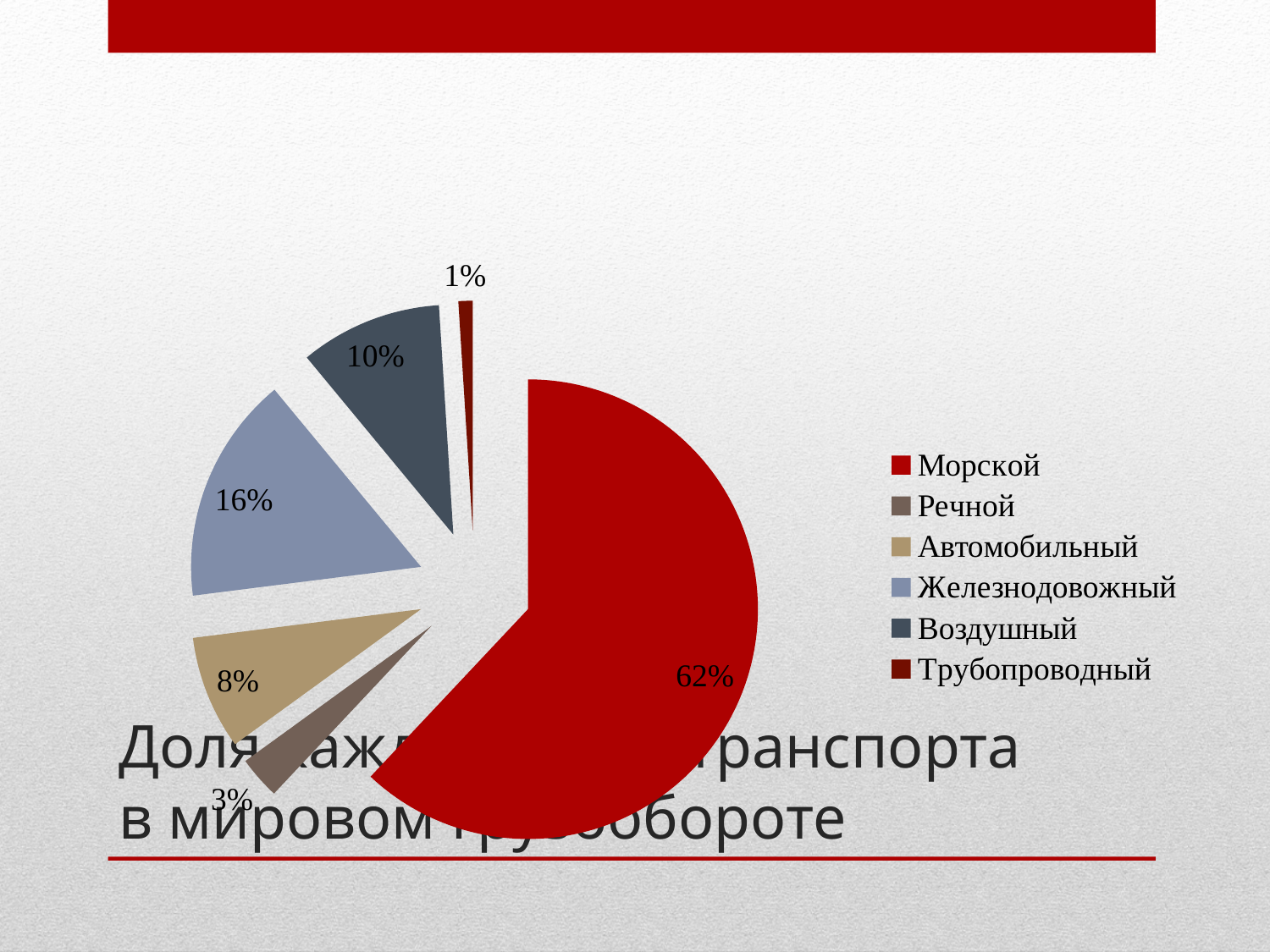
What is the value shown for Железнодовожный? 16% What is the difference between the values for Железнодовожный and Воздушный? 6% Which category has the largest slice of the pie? Морской What is the value shown for Трубопроводный? 1% How many categories does the legend list? 6 What kind of chart is shown on the slide? pie chart Which is larger, the value for Автомобильный or the value for Речной? Автомобильный What is the value shown for Автомобильный? 8% What is the value shown for Воздушный? 10% Which category has the smallest slice of the pie? Трубопроводный What is the value shown for Речной? 3% What share of the pie does Морской have? 62%